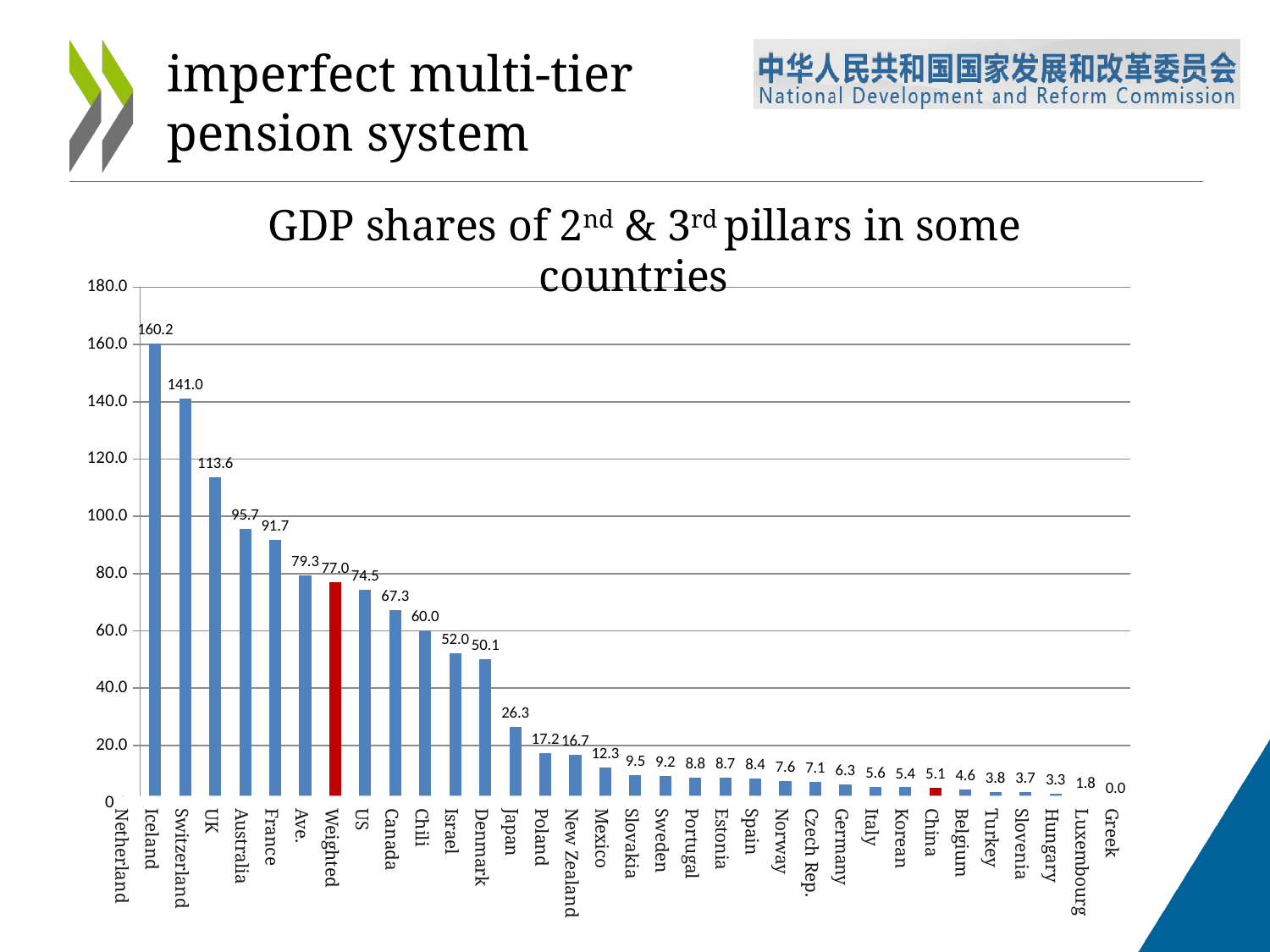
What is the value of the Weighted bar? 77.0 What is the value shown for Luxembourg? 1.8 What is the difference between the values for the US and Canada? 7.2 Which has a larger value, Mexico or Poland? Poland What is the value shown for the US? 74.5 What is the value shown for Japan? 26.3 Which country has the lowest value in the chart? Greek What kind of chart is shown on the slide? bar chart Do the values rise or fall moving from left to right along the x axis? fall What is the value shown for China? 5.1 Which two bars are coloured red instead of blue? Weighted and China Is the value for Denmark greater or less than 40.0? greater